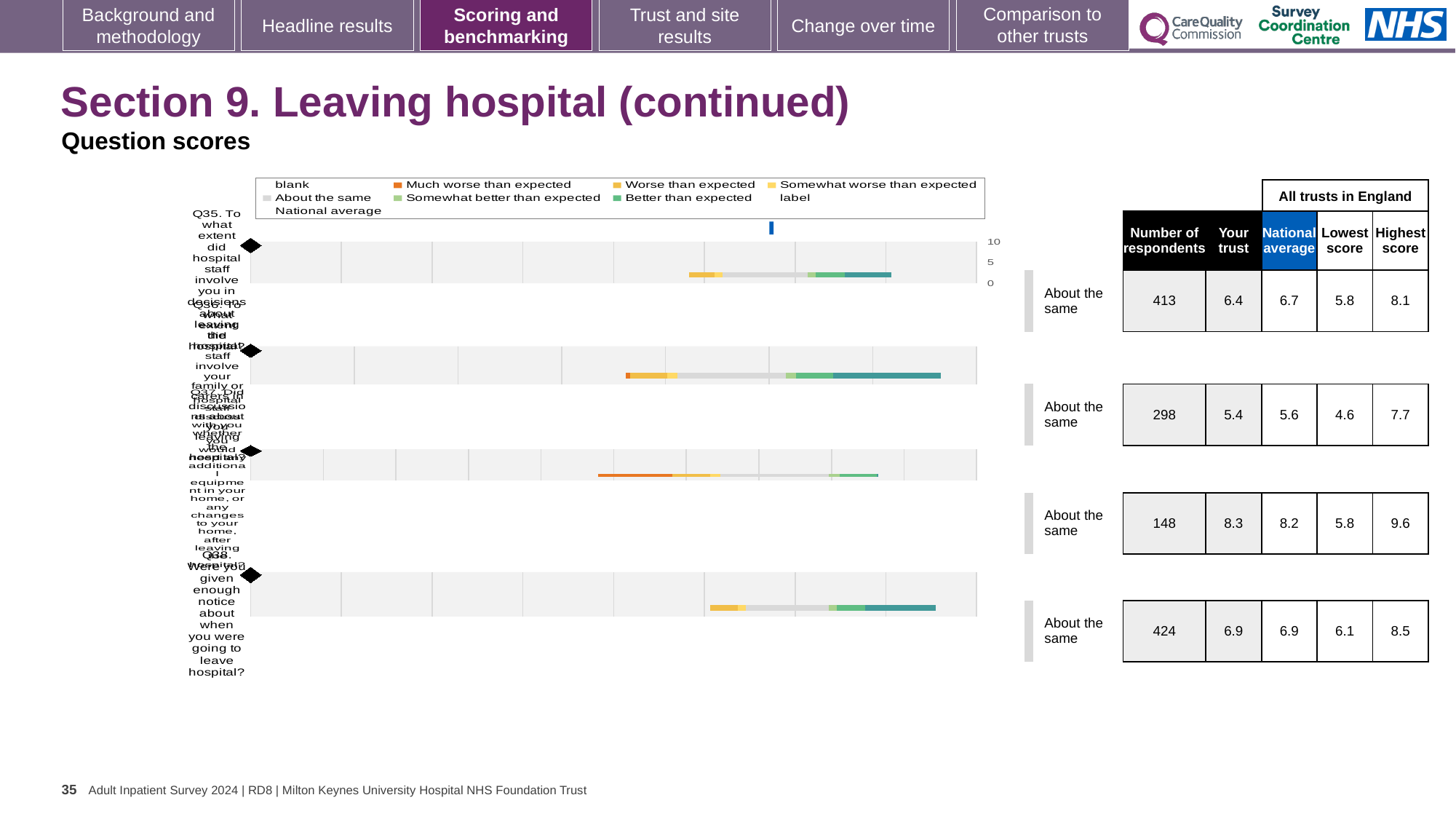
Which of the four questions has the lowest 'Your trust' score? Q36 How many respondents answered Q38 (given enough notice about when you were going to leave hospital)? 424 What is the highest score across all trusts in England for Q38 (given enough notice about leaving hospital)? 8.5 What is the benchmark category shown for Q35 (involving you in decisions about leaving hospital)? About the same Is the 'Your trust' score for Q38 larger or smaller than the national average for Q38? They are equal (6.9) How many questions (rows) are plotted in the question scores chart? 4 What is the national average for Q35 (involving you in decisions about leaving hospital)? 6.7 What is the difference between the 'Your trust' score and the national average for Q35? 0.3 What is the 'Your trust' score for Q35 (involving you in decisions about leaving hospital)? 6.4 Which of the four questions has the highest 'Your trust' score? Q37 What kind of chart is used to show the question scores on this slide? bar chart Which legend entry is shown in dark orange in the question scores chart? Much worse than expected